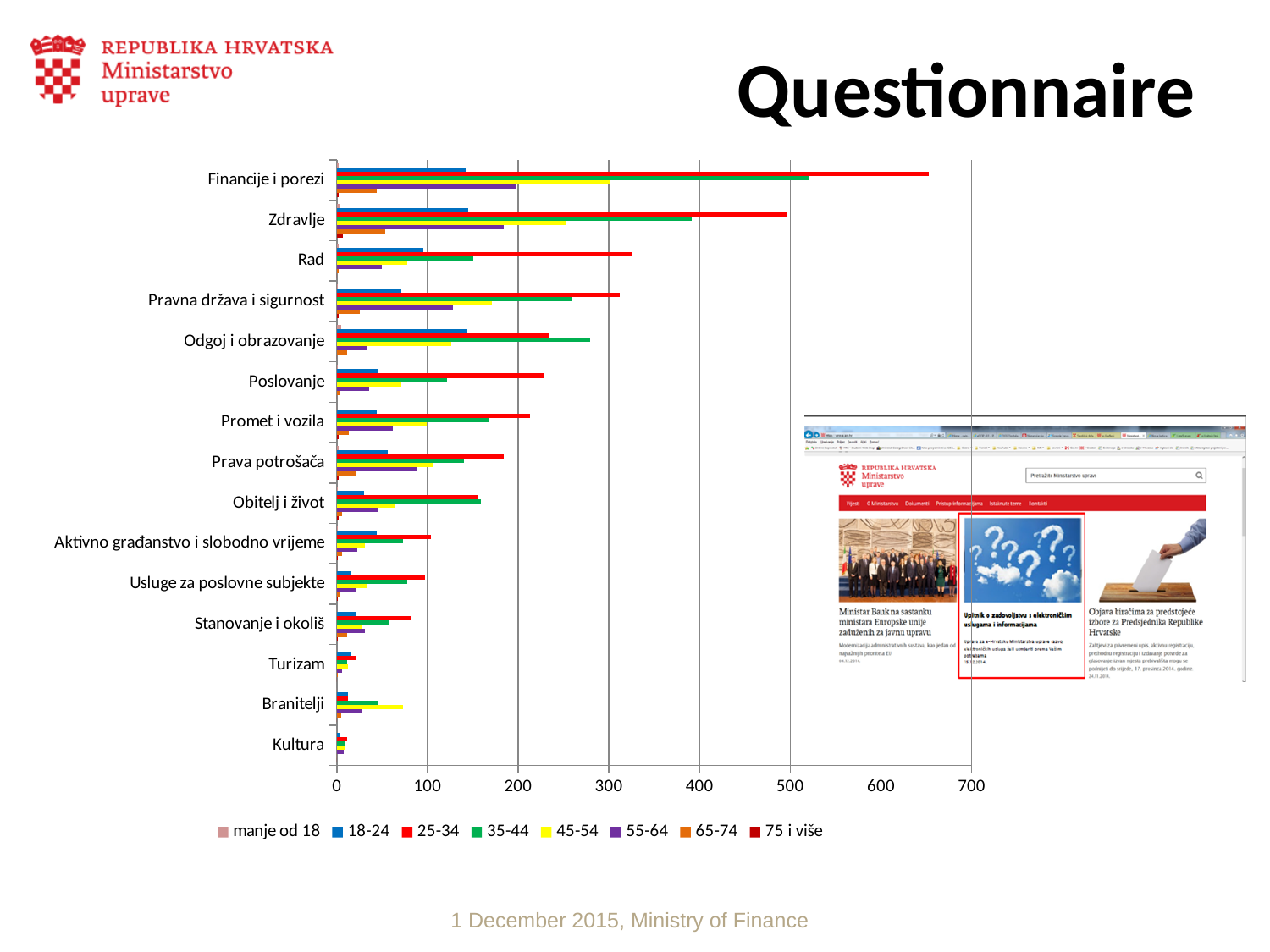
Which category has the shortest bars overall in the chart? Kultura What kind of chart is shown on the slide? bar chart Is the value for the 25-34 series in Financije i porezi greater or less than 600? greater Which category has the longest bar for the 25-34 series? Financije i porezi How many categories are listed on the vertical axis of the chart? 15 Is the value for the 35-44 series in Zdravlje greater or less than 400? less For Odgoj i obrazovanje, which series has the larger value: 25-34 or 35-44? 35-44 Which is larger for the 25-34 series: Financije i porezi or Zdravlje? Financije i porezi How many series does the chart legend list? 8 What is the first series listed in the chart legend? manje od 18 Is the value for the 35-44 series in Financije i porezi greater or less than 500? greater